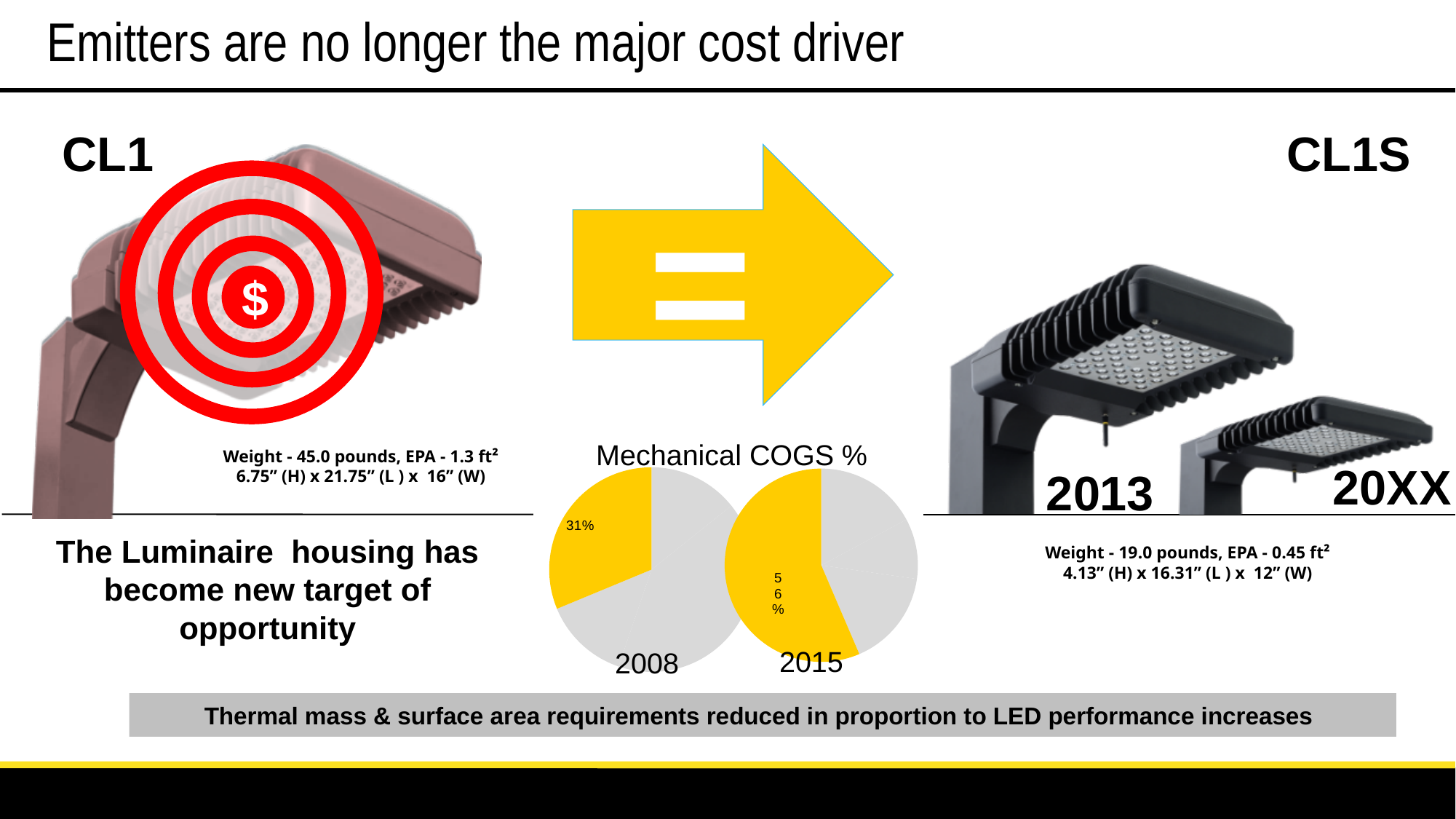
What kind of charts are shown under the title "Mechanical COGS %"? Pie charts How many pie charts are shown under the "Mechanical COGS %" title? 2 In the "Mechanical COGS %" charts, what percentage is labelled on the yellow slice of the 2015 pie? 56% In the "Mechanical COGS %" charts, which year has the larger labelled yellow slice, 2008 or 2015? 2015 What is the title of the pie charts on the slide? Mechanical COGS % In the "Mechanical COGS %" charts, what percentage is labelled on the yellow slice of the 2008 pie? 31% Does the labelled Mechanical COGS % share rise or fall from 2008 to 2015? Rise Which years are labelled under the two "Mechanical COGS %" pie charts? 2008 and 2015 In the "Mechanical COGS %" charts, what share of the 2008 pie is the grey slice? 69% In the "Mechanical COGS %" charts, by how many percentage points does the labelled slice for 2015 exceed the one for 2008? 25 percentage points In the "Mechanical COGS %" charts, which year has the smaller labelled yellow slice? 2008